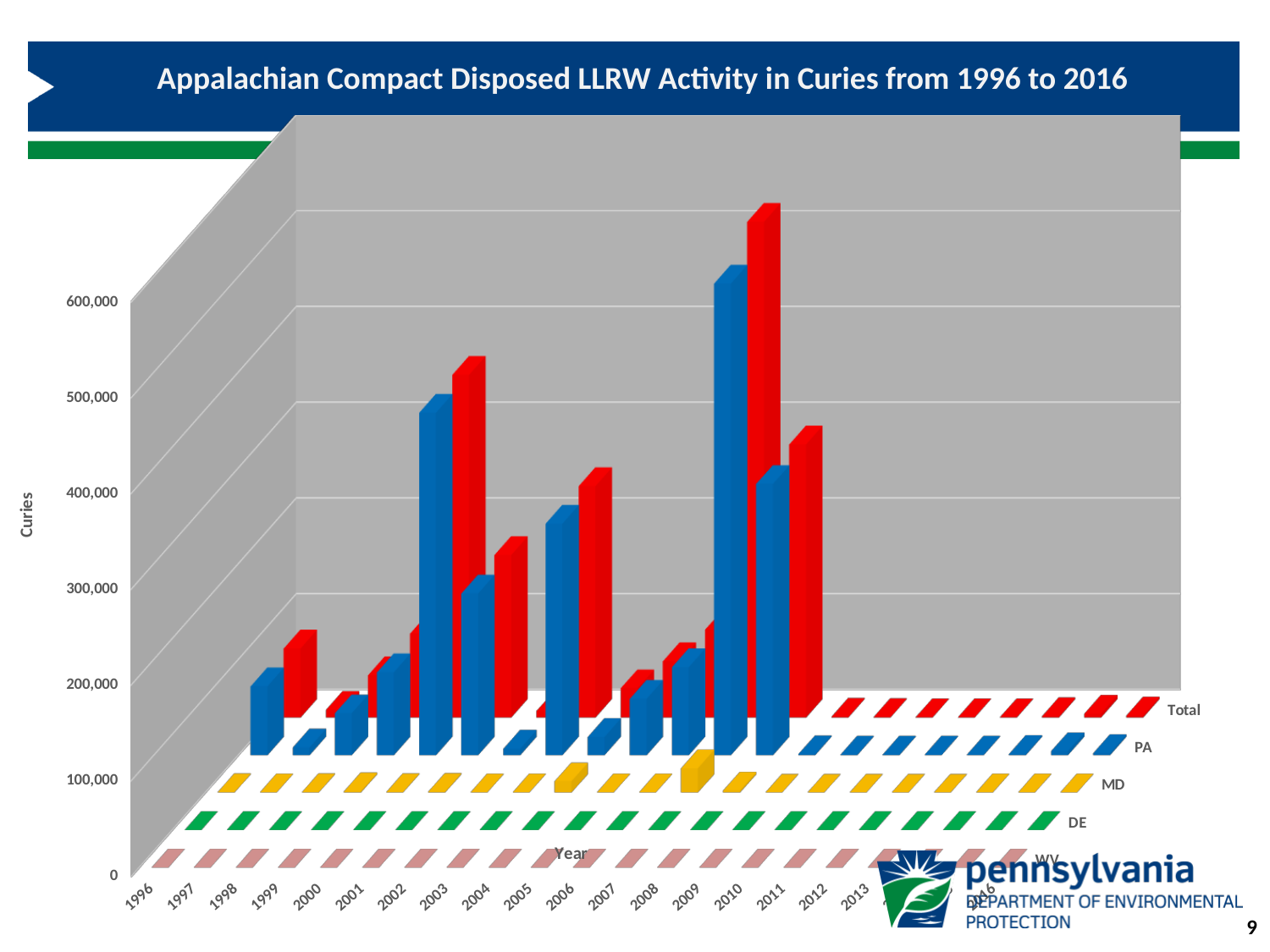
How many years are plotted along the x axis of the chart? 21 Which is larger, the Total value for 2003 or the Total value for 2006? 2003 What kind of chart is shown on the slide? bar chart How many series does the chart's legend list? 5 Which is larger, the Total value for 2010 or the Total value for 2003? 2003 What is the label on the vertical axis of the chart? Curies Which is larger, the PA value for 2010 or the PA value for 2011? 2010 In which year is the Total series highest? 2007 What is the title of the chart? Appalachian Compact Disposed LLRW Activity in Curies from 1996 to 2016